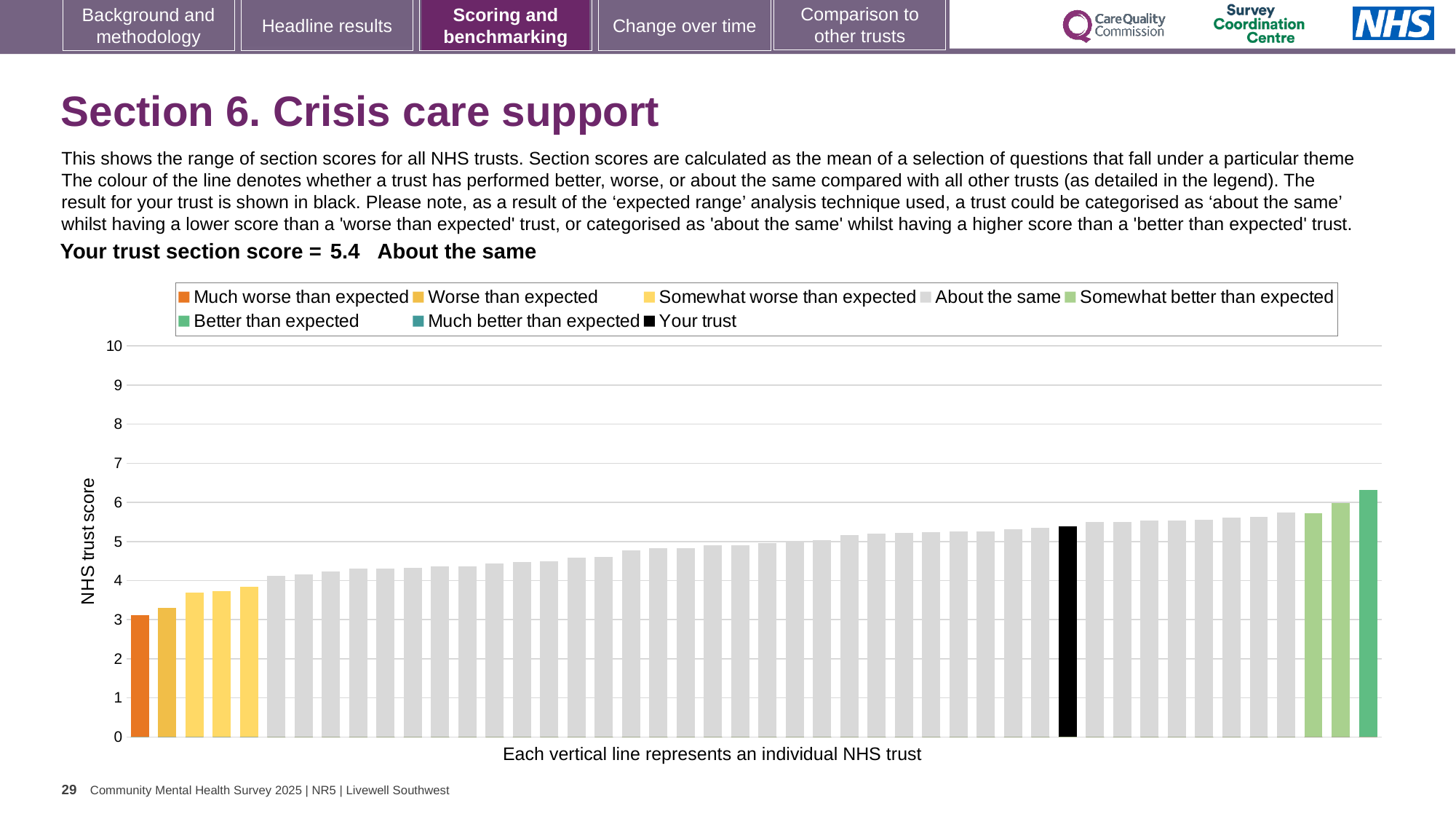
Is the value of the lowest bar (the orange 'Much worse than expected' trust) greater or less than 4? less What is the label on the vertical axis of the chart? NHS trust score What kind of chart is shown on the slide? Bar chart What colour is used for the 'Your trust' bar in the chart? Black Is the value of the tallest bar on the chart greater or less than 5? greater Do the bar values rise or fall moving from left to right along the x axis? rise Which legend category does the shortest bar on the chart belong to? Much worse than expected How many entries does the chart legend list? 8 Is the value of the black 'Your trust' bar greater or less than 5? greater Which legend category does the tallest bar on the chart belong to? Better than expected Which category is your trust placed in for this section? About the same What is the section score for your trust shown on the slide? 5.4